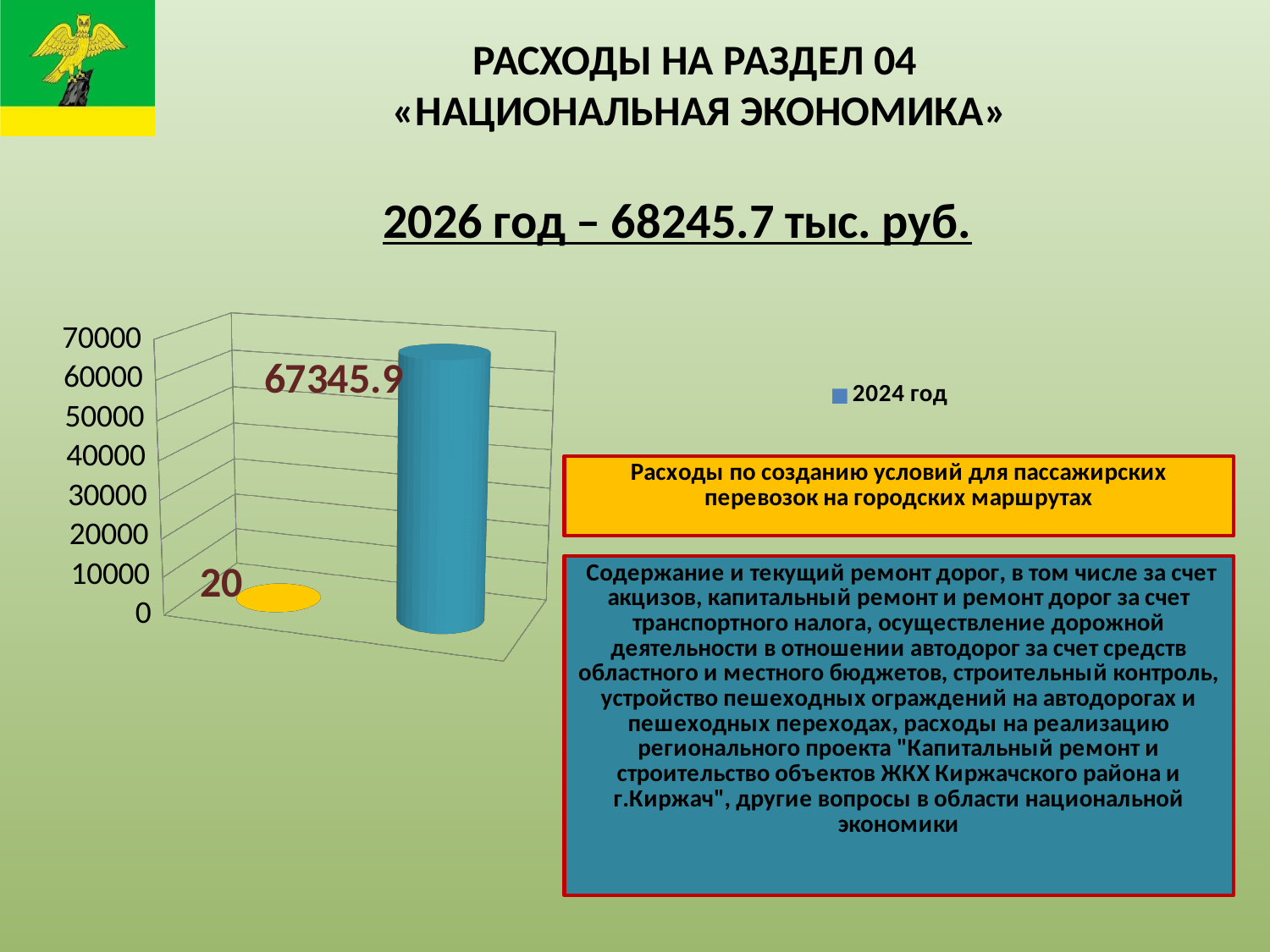
Is the value of the blue bar in the chart greater or less than 60000? greater Which bar in the chart has the lowest value, the blue one or the yellow one? the yellow one What is the highest value shown on the vertical axis of the chart? 70000 What is the legend entry shown next to the chart? 2024 год What value is shown on the blue bar in the chart? 67345.9 Is the value of the yellow bar in the chart greater or less than 10000? less What value is shown on the yellow bar in the chart? 20 How many entries does the chart legend list? 1 Which bar in the chart has the highest value, the blue one or the yellow one? the blue one How many bars are plotted in the chart? 2 What is the difference between the values of the blue bar and the yellow bar in the chart? 67325.9 What kind of chart is shown on the slide? bar chart